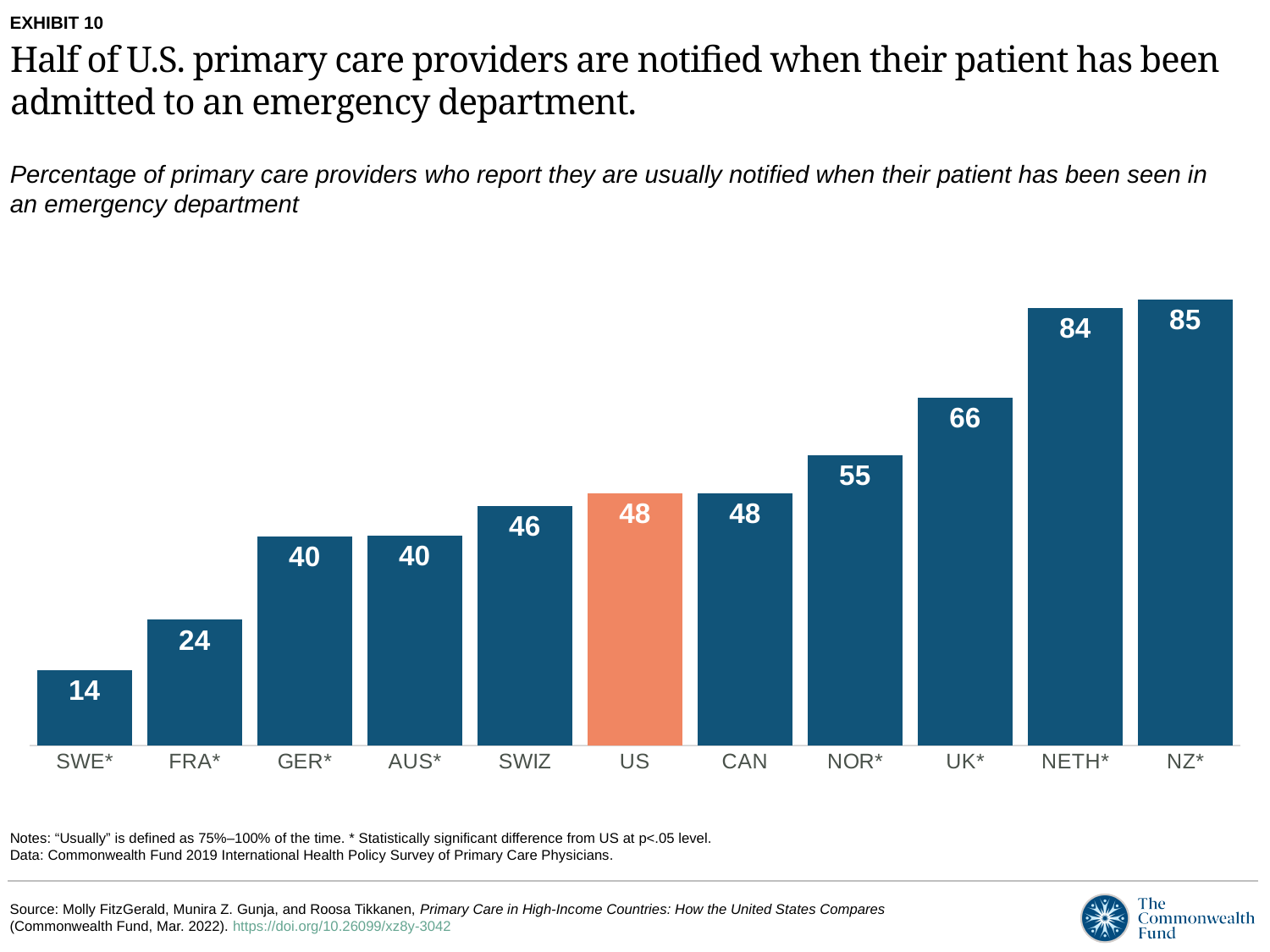
What is the value for the US? 48 Do the values rise or fall from left to right along the x axis? Rise Which country has the highest value? NZ* What is the difference between the values for UK* and NOR*? 11 Which is larger, the value for FRA* or the value for SWIZ? SWIZ What is the value for NETH*? 84 Which bar is highlighted in a different colour (orange) from the others? US What kind of chart is shown on the slide? Bar chart What is the value for SWE*? 14 Which country has the lowest value? SWE* What is the difference between the values for NZ* and the US? 37 How many countries are shown in the chart? 11